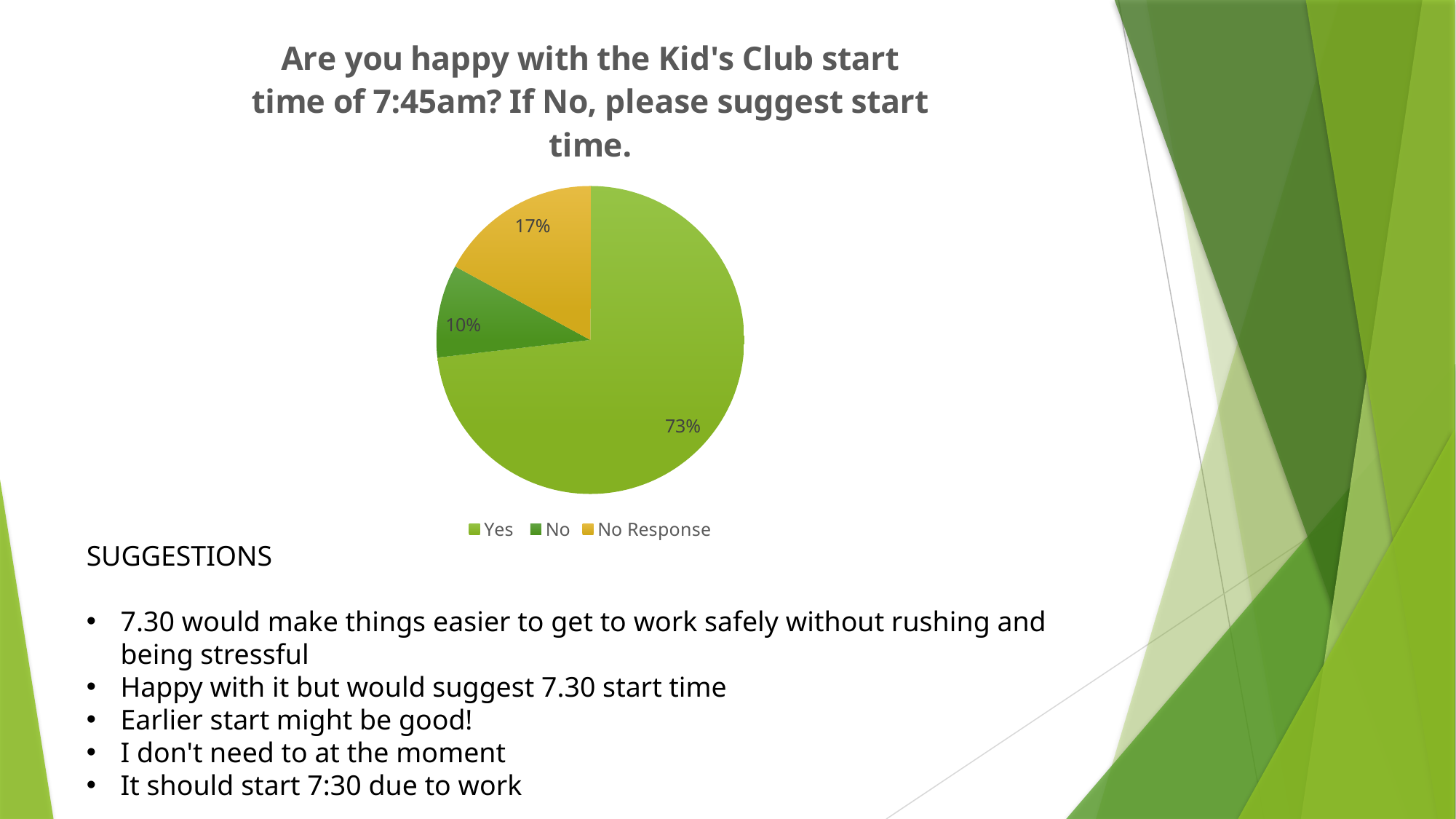
What percentage of respondents gave No Response? 17% What kind of chart is shown on the slide? pie chart What is the difference in percentage points between No Response and No? 7% Which category has the smallest share of the pie? No What is the title of the chart? Are you happy with the Kid's Club start time of 7:45am? If No, please suggest start time. What is the difference in percentage points between Yes and No Response? 56% What percentage of respondents answered Yes? 73% Which category has the largest share of the pie? Yes Which is larger, the share for No or the share for No Response? No Response What percentage of respondents answered No? 10% What colour is the No Response slice? yellow/gold How many categories does the pie chart have? 3